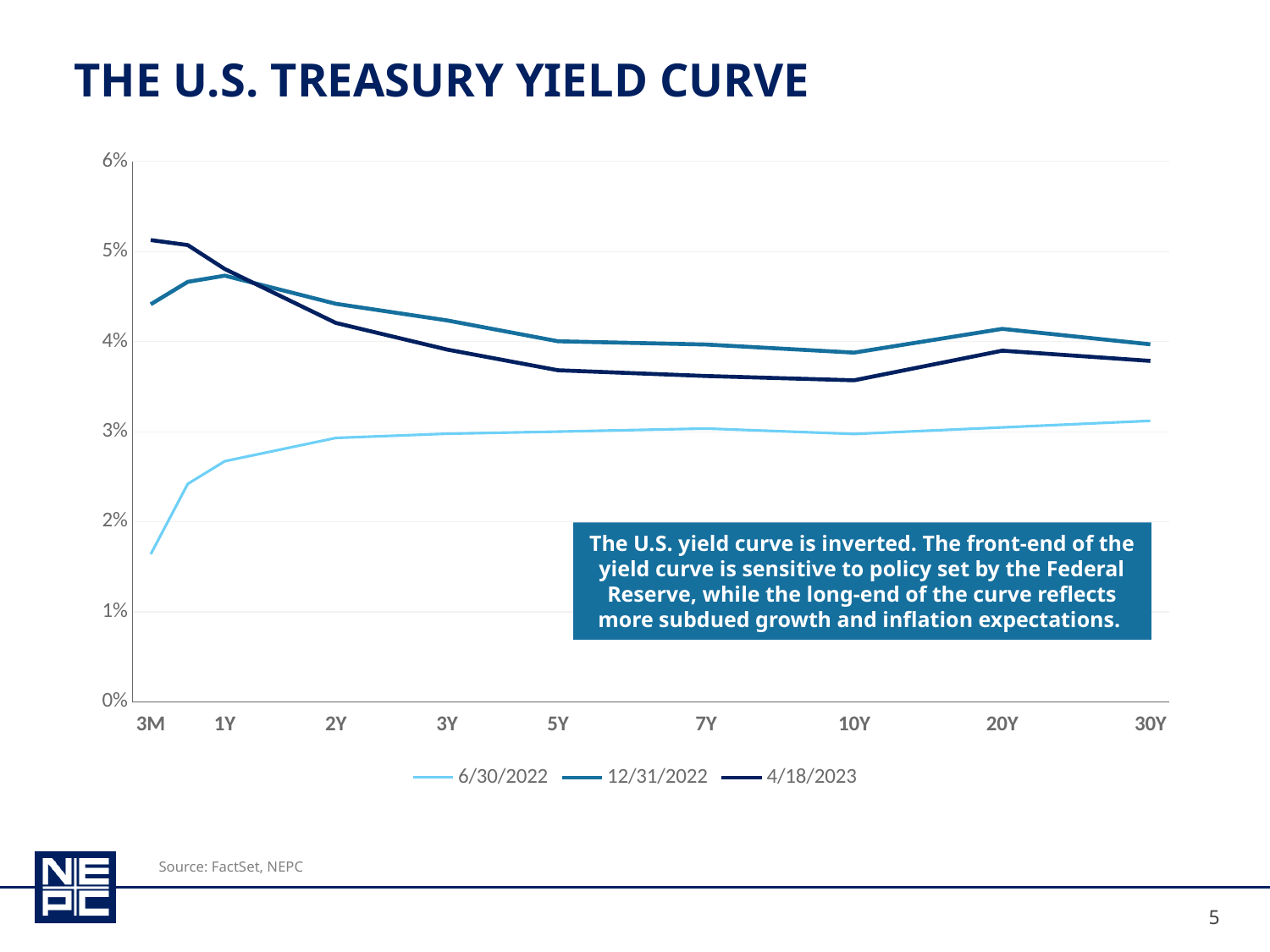
At 3M, which series has the higher yield, 4/18/2023 or 12/31/2022? 4/18/2023 Which series has the lowest yield at 30Y? 6/30/2022 What are the three dates listed in the legend? 6/30/2022, 12/31/2022, 4/18/2023 Is the 4/18/2023 value at 10Y greater or less than 4%? less What kind of chart is shown on the slide? line chart Is the 4/18/2023 value at 3M greater or less than 5%? greater At 10Y, which series has the higher yield, 12/31/2022 or 4/18/2023? 12/31/2022 How many maturity labels are shown on the x axis? 9 Is the 12/31/2022 value at 3M greater or less than 4%? greater What is the title of the chart? THE U.S. TREASURY YIELD CURVE How many series does the legend list? 3